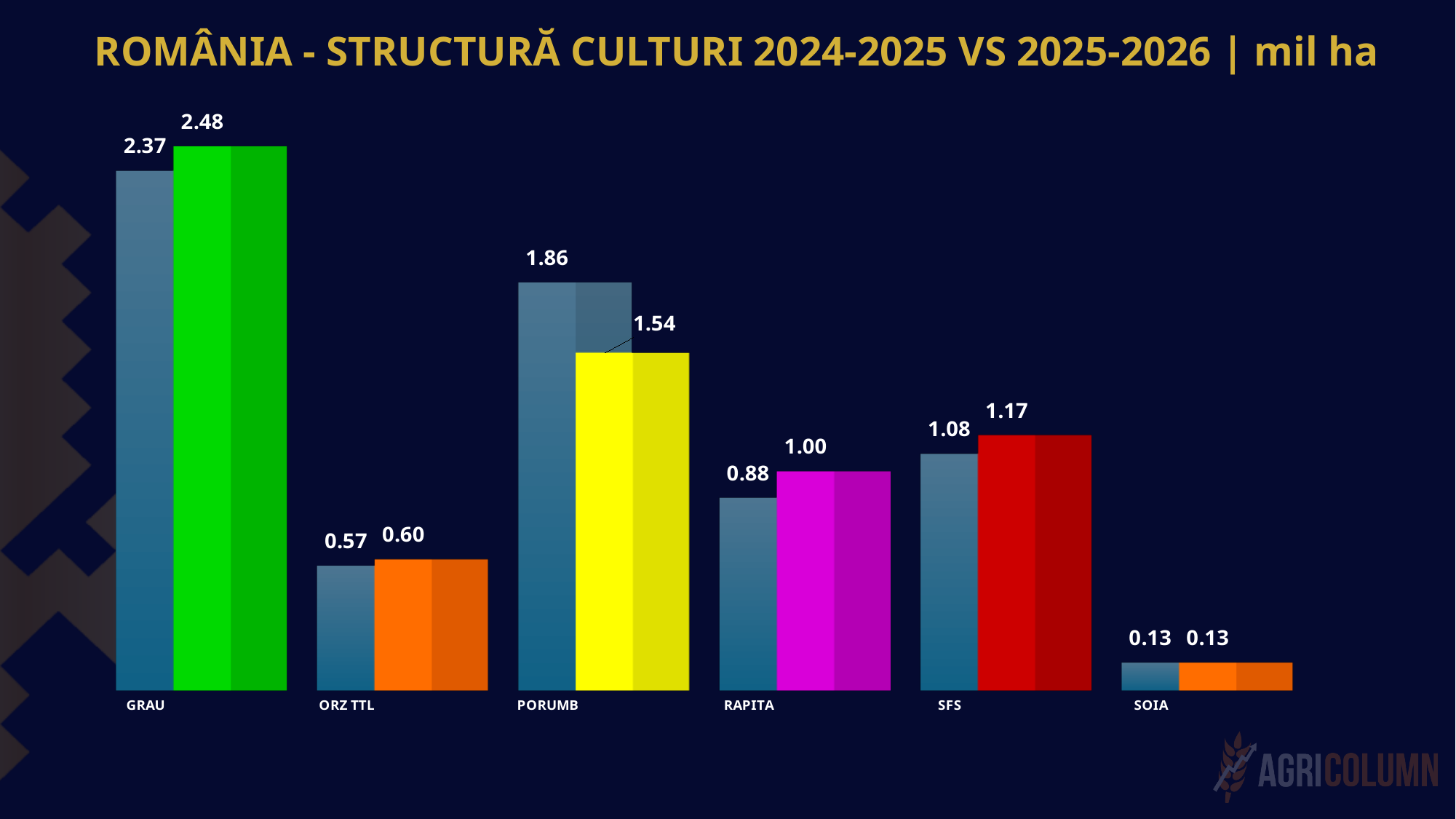
What is the value of the green bar for GRAU? 2.48 What is the value of the left (blue) bar for GRAU? 2.37 For PORUMB, which bar is larger: the left (blue) bar or the yellow bar? the left (blue) bar What is the difference between the two bars for PORUMB (1.86 and 1.54)? 0.32 What is the value of the yellow bar for PORUMB? 1.54 How many crop categories are shown on the x axis? 6 What is the difference between the two bars for GRAU (2.48 and 2.37)? 0.11 Which category has the highest value among the left (blue) bars? GRAU What kind of chart is shown on the slide? bar chart What is the value of the red bar for SFS? 1.17 Which category has the lowest value among the right (coloured) bars? SOIA For RAPITA, which bar is larger: the left (blue) bar or the magenta bar? the magenta bar